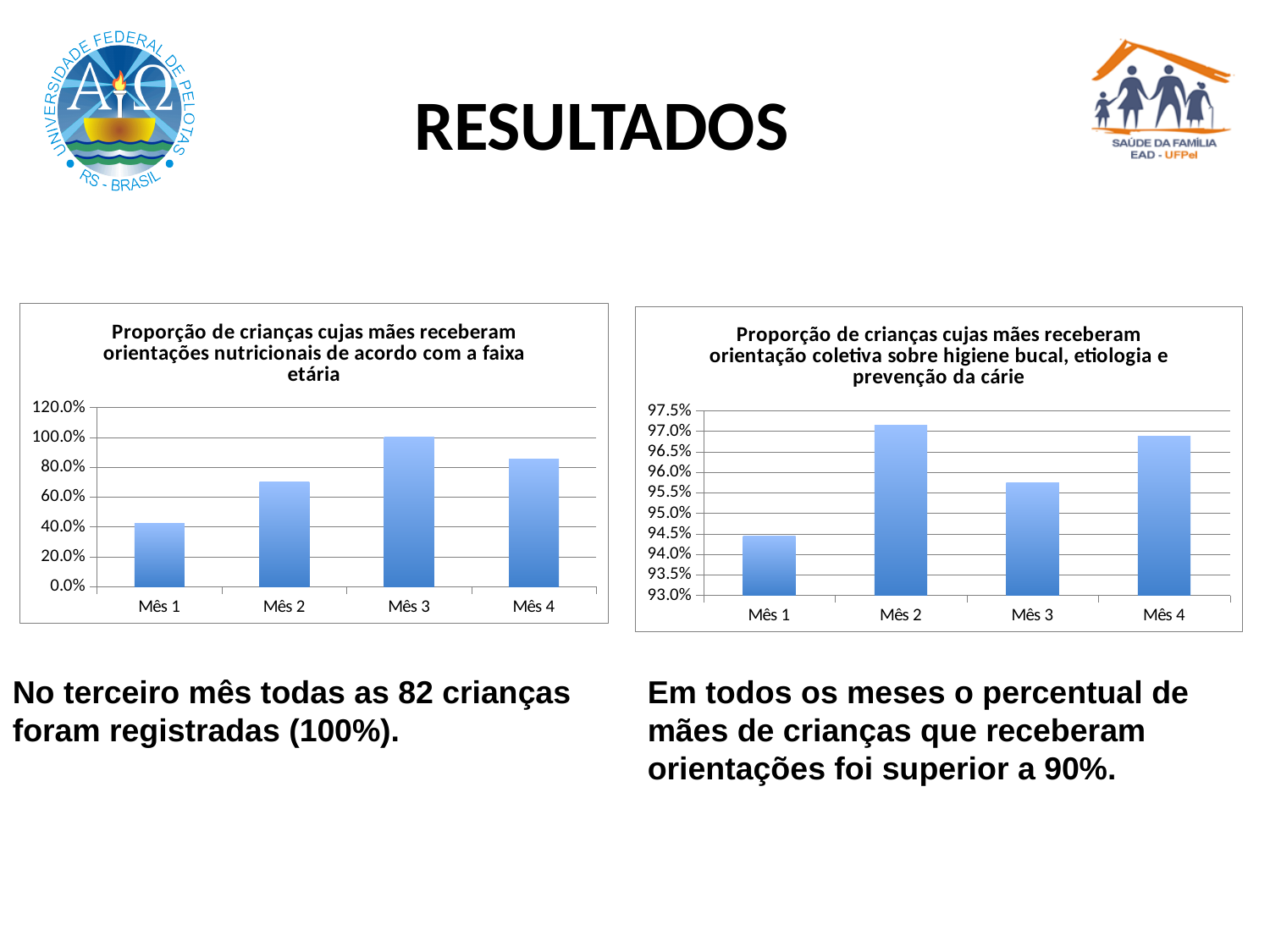
In the chart titled 'Proporção de crianças cujas mães receberam orientações nutricionais de acordo com a faixa etária', is the value for Mês 1 greater or less than 60.0%? less In the chart titled 'Proporção de crianças cujas mães receberam orientação coletiva sobre higiene bucal, etiologia e prevenção da cárie', which month has the lowest value? Mês 1 In the chart titled 'Proporção de crianças cujas mães receberam orientações nutricionais de acordo com a faixa etária', how many months are plotted? 4 In the chart titled 'Proporção de crianças cujas mães receberam orientação coletiva sobre higiene bucal, etiologia e prevenção da cárie', which is larger, the value for Mês 2 or Mês 3? Mês 2 In the chart titled 'Proporção de crianças cujas mães receberam orientações nutricionais de acordo com a faixa etária', which month has the lowest value? Mês 1 In the chart titled 'Proporção de crianças cujas mães receberam orientações nutricionais de acordo com a faixa etária', which is larger, the value for Mês 2 or Mês 4? Mês 4 In the chart titled 'Proporção de crianças cujas mães receberam orientações nutricionais de acordo com a faixa etária', which month has the highest value? Mês 3 In the chart titled 'Proporção de crianças cujas mães receberam orientações nutricionais de acordo com a faixa etária', what kind of chart is shown? bar chart In the chart titled 'Proporção de crianças cujas mães receberam orientações nutricionais de acordo com a faixa etária', what is the value for Mês 3? 100.0% In the chart titled 'Proporção de crianças cujas mães receberam orientações nutricionais de acordo com a faixa etária', is the value for Mês 4 greater or less than 80.0%? greater In the chart titled 'Proporção de crianças cujas mães receberam orientação coletiva sobre higiene bucal, etiologia e prevenção da cárie', is the value for Mês 3 greater or less than 95.0%? greater